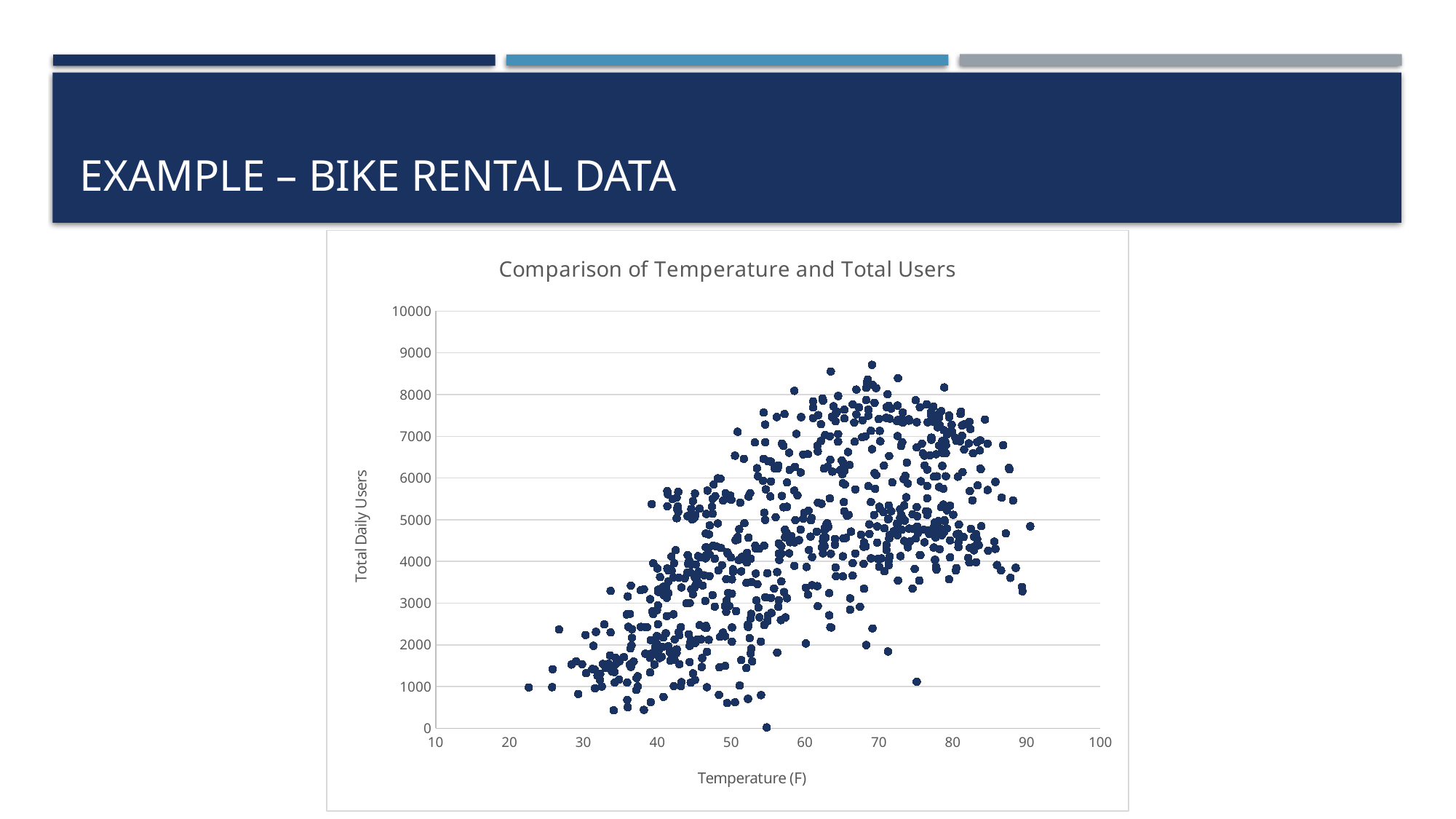
Is the lowest plotted value of Total Daily Users greater or less than 1000? less Is the lowest temperature among the plotted points greater or less than 30? less Are there any plotted points with a temperature below 20? No What is the label of the x axis? Temperature (F) What is the maximum value shown on the y axis? 10000 Do total daily users generally rise or fall as temperature increases along the x axis? Rise What is the title of the chart? Comparison of Temperature and Total Users What kind of chart is shown on the slide? Scatter plot